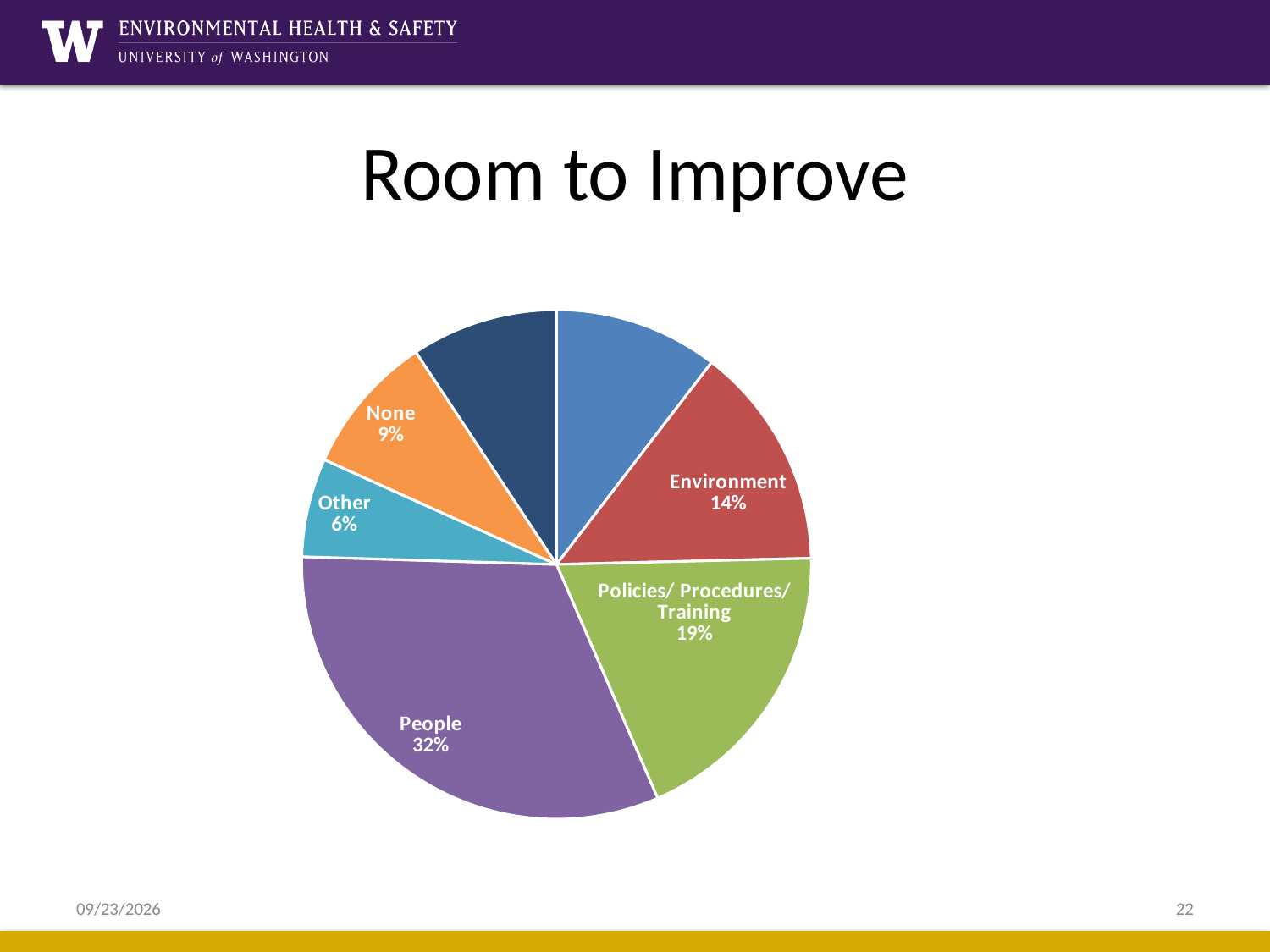
Which is larger, the Policies/ Procedures/ Training slice or the Environment slice? Policies/ Procedures/ Training Which slice of the pie is the largest? People What percentage of the pie does the People slice represent? 32% How many slices does the pie chart have? 7 What is the value shown for the Policies/ Procedures/ Training slice? 19% What kind of chart is shown on the slide? Pie chart What is the difference between the People slice and the Environment slice? 18% What is the value shown for the Environment slice? 14% Which slice of the pie is the smallest? Other What is the title of the slide containing the pie chart? Room to Improve What is the value shown for the None slice? 9% What is the difference between the Policies/ Procedures/ Training slice and the None slice? 10%